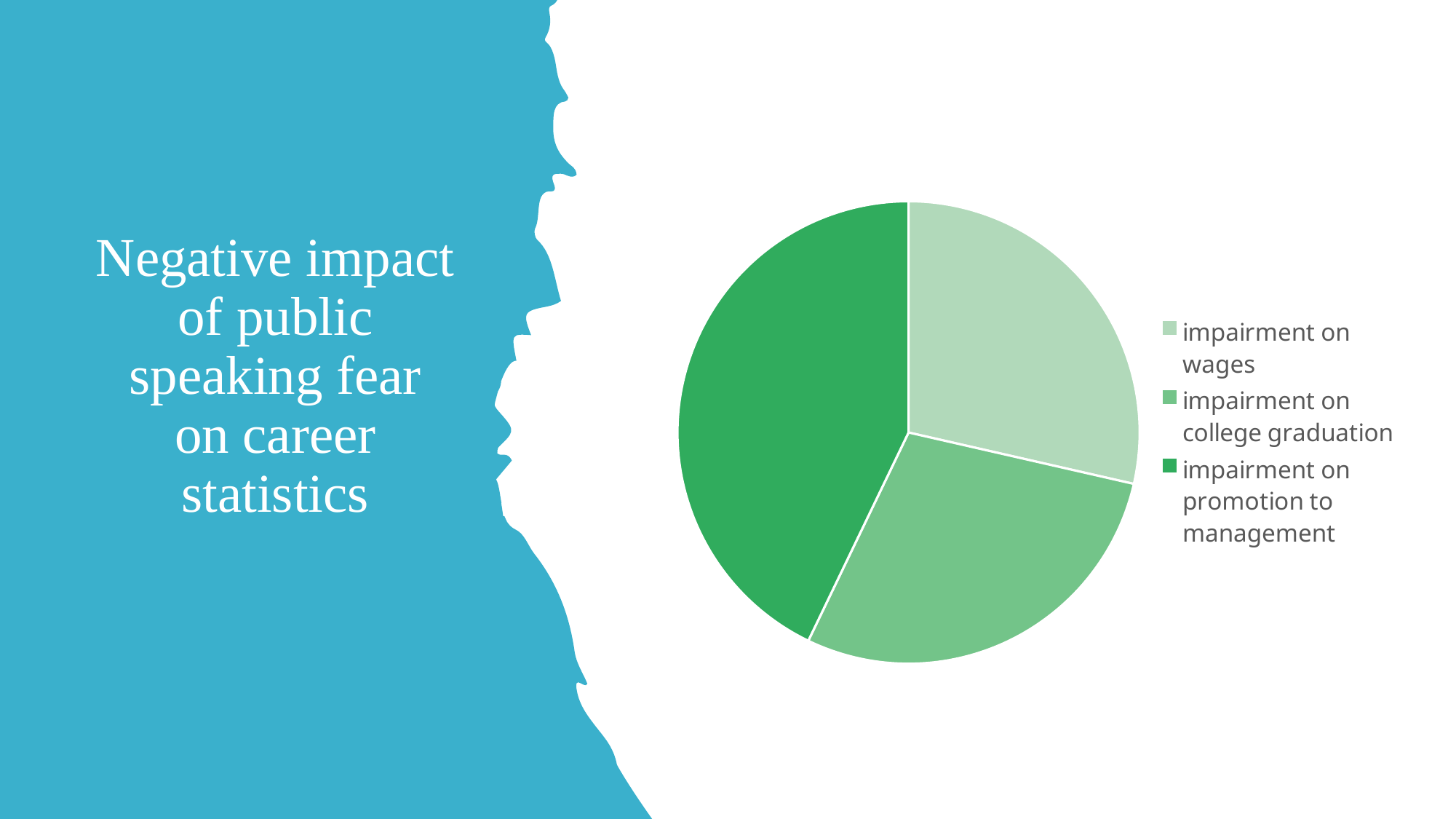
How many slices does the pie chart have? 3 Which legend entry is shown in the darkest green colour? impairment on promotion to management How many entries does the legend of the pie chart list? 3 Which slice is larger: impairment on promotion to management or impairment on college graduation? impairment on promotion to management Which slice is larger: impairment on promotion to management or impairment on wages? impairment on promotion to management Which category has the largest slice of the pie chart? impairment on promotion to management What is the title text shown on the slide next to the pie chart? Negative impact of public speaking fear on career statistics What kind of chart is shown on the slide? pie chart